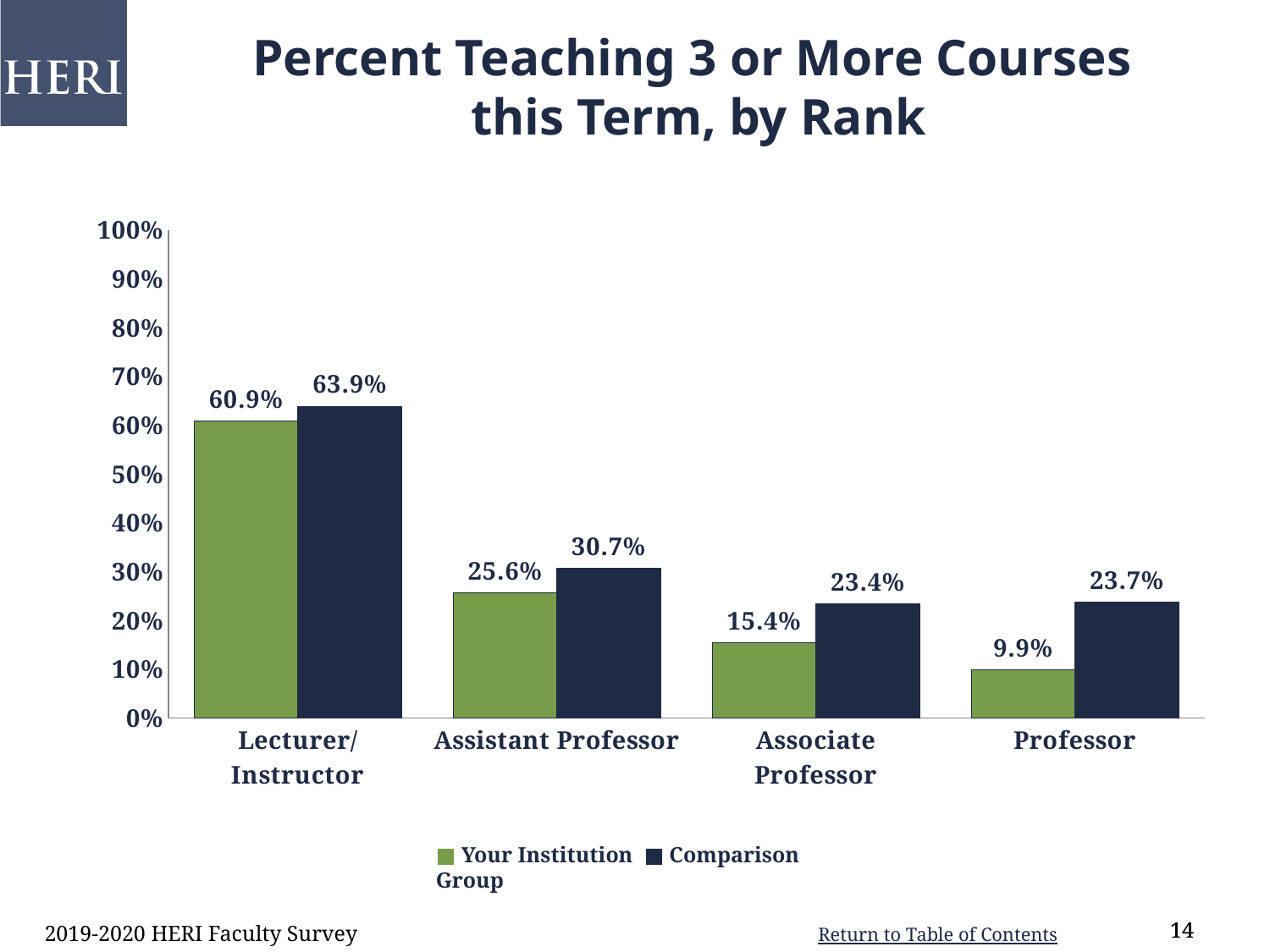
Which rank has the highest value for Your Institution? Lecturer/Instructor What is the difference between the Comparison Group and Your Institution values for Professor? 13.8% Which is larger for Associate Professor: Your Institution or Comparison Group? Comparison Group What is the value for Comparison Group for Associate Professor? 23.4% What is the value for Your Institution for Professor? 9.9% How many rank categories are shown on the x axis? 4 Do the Your Institution values rise or fall from Lecturer/Instructor to Professor? Fall What is the value for Comparison Group for Assistant Professor? 30.7% Which rank has the lowest value for Your Institution? Professor What is the value for Your Institution for Lecturer/Instructor? 60.9% What kind of chart is shown on the slide? Bar chart How many series does the legend list? 2